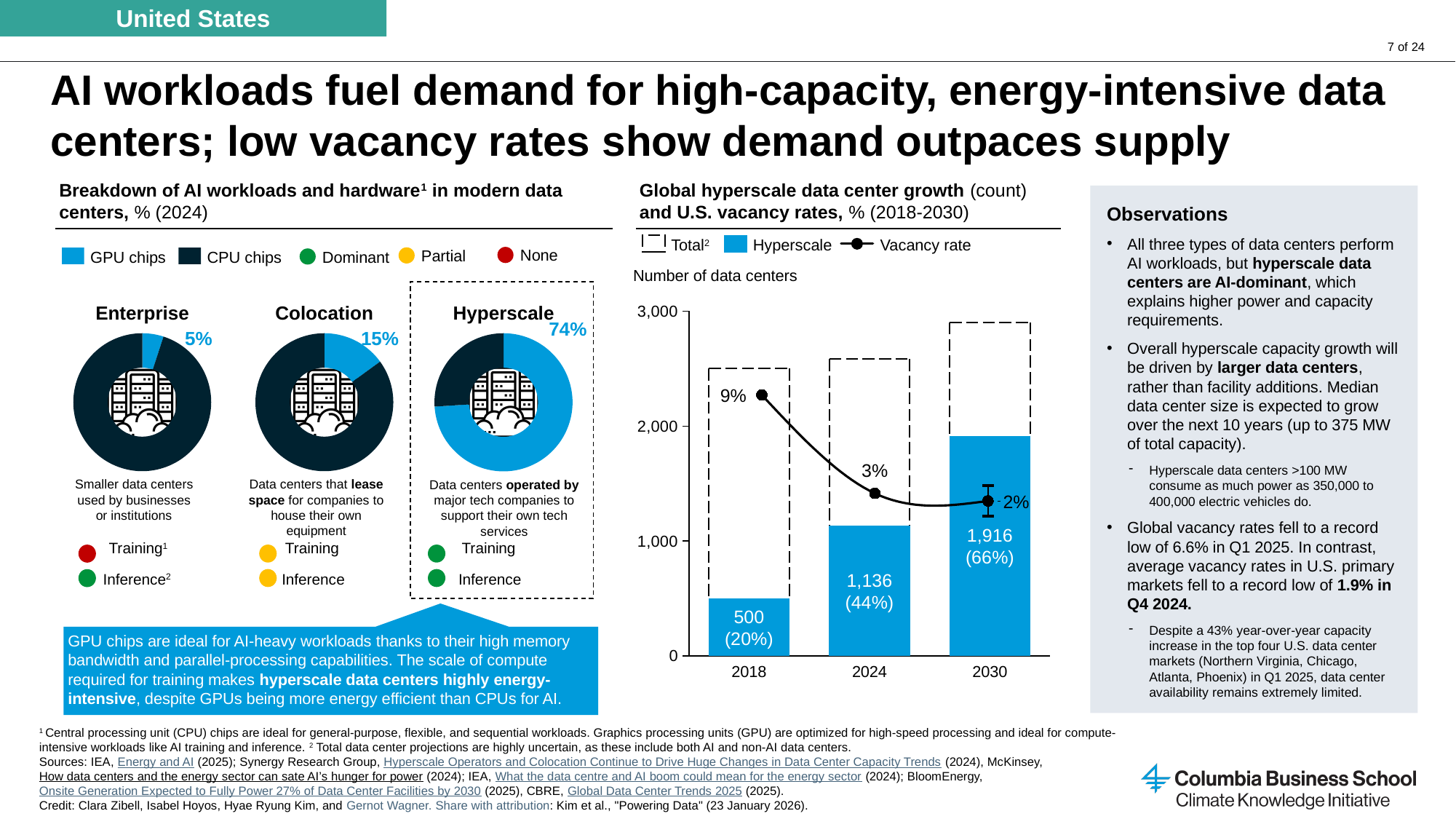
In the 'Global hyperscale data center growth' chart, does the vacancy rate rise or fall from 2018 to 2030? Fall In the 'Breakdown of AI workloads and hardware' chart, how many percentage points higher is the GPU chip share for hyperscale than for colocation? 59 percentage points In the 'Global hyperscale data center growth' chart, is the total number of data centers in 2018 greater or less than 2,000? greater In the 'Global hyperscale data center growth' chart, what share of total data centers are hyperscale in 2030? 66% In the 'Global hyperscale data center growth' chart, how many hyperscale data centers are shown for 2024? 1,136 In the 'Breakdown of AI workloads and hardware' chart, which data center type has the highest GPU chip share? Hyperscale In the 'Global hyperscale data center growth' chart, what is the U.S. vacancy rate in 2018? 9% In the 'Breakdown of AI workloads and hardware' chart, what is the GPU chip share for enterprise data centers? 5% In the 'Global hyperscale data center growth' chart, by how much does the number of hyperscale data centers increase from 2018 to 2030? 1,416 How many series does the legend of the 'Global hyperscale data center growth' chart list? 3 In the 'Breakdown of AI workloads and hardware' chart, what share of chips in hyperscale data centers are GPU chips? 74% How many donut charts are shown in the 'Breakdown of AI workloads and hardware' section? 3